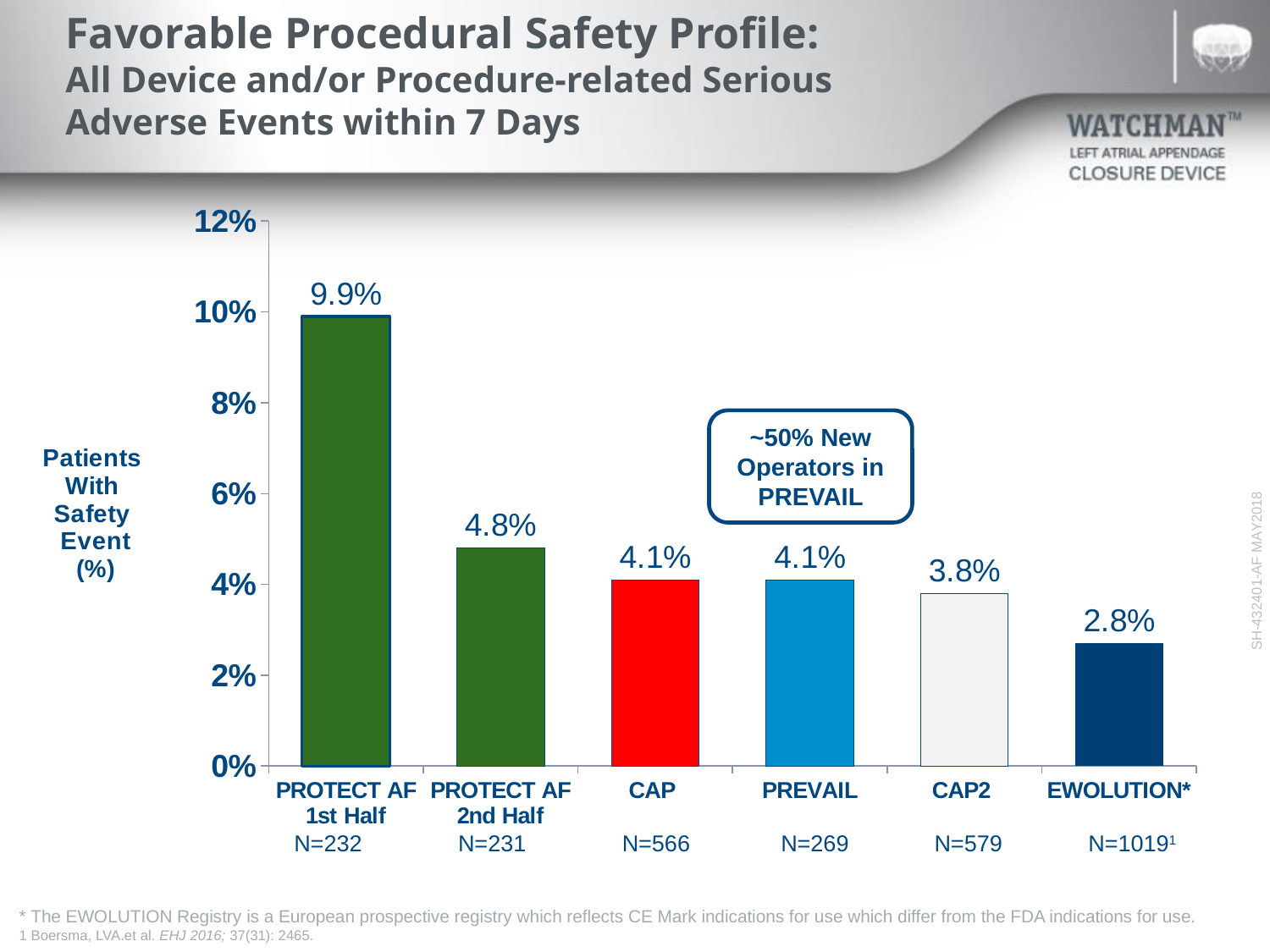
What is the value for EWOLUTION*? 2.8% What is the value for PROTECT AF 1st Half? 9.9% Do the values rise or fall from left to right along the x axis? fall What is the label on the y axis? Patients With Safety Event (%) Which category has the highest value? PROTECT AF 1st Half What kind of chart is shown on the slide? bar chart How many categories are shown on the x axis? 6 Which category has the lowest value? EWOLUTION* What is the difference between the values for PROTECT AF 1st Half and PROTECT AF 2nd Half? 5.1% What is the value for CAP2? 3.8% Is the value for PREVAIL greater or less than 6%? less Which is larger, the value for PROTECT AF 2nd Half or the value for CAP2? PROTECT AF 2nd Half